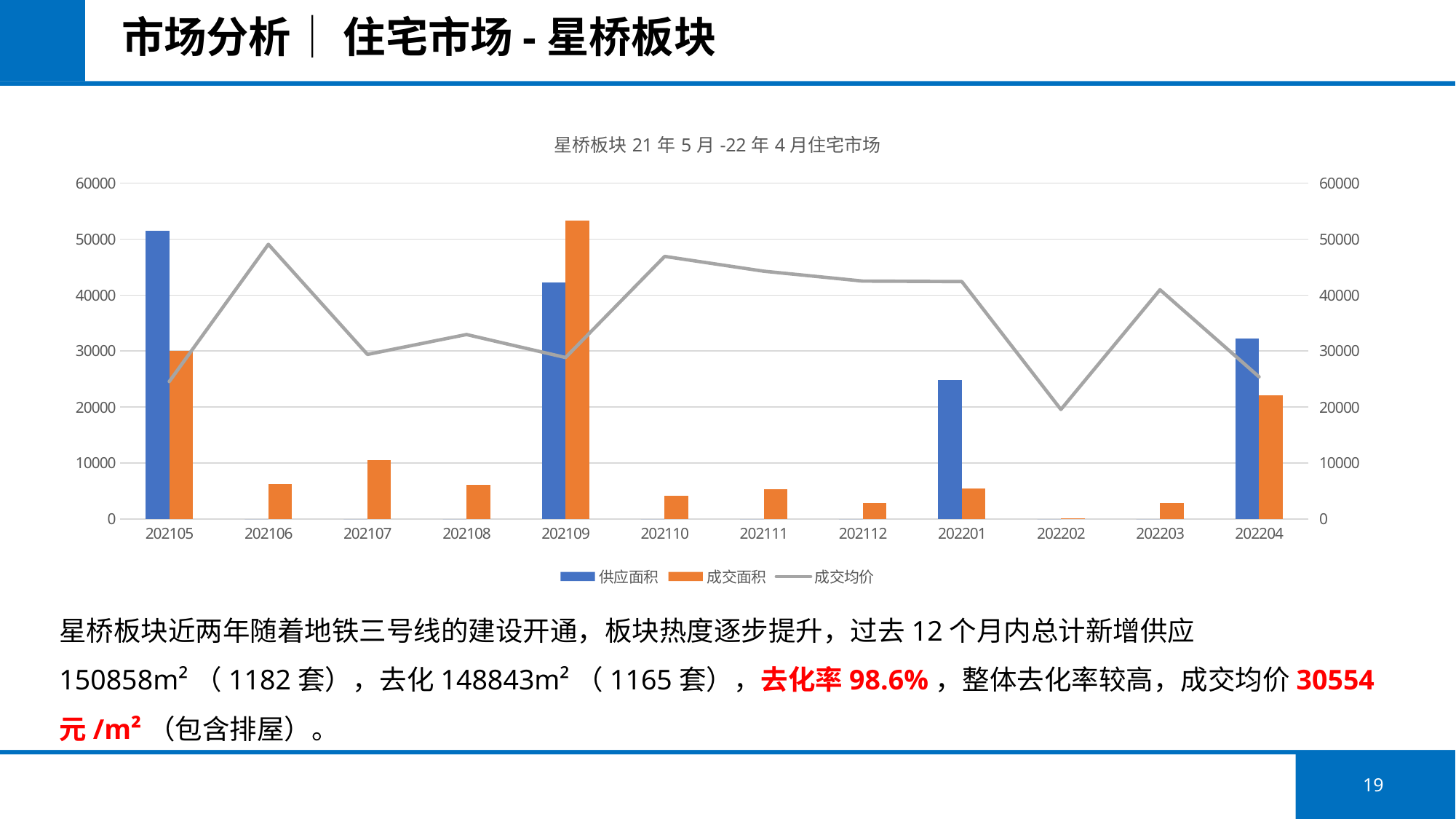
In 202105, which is larger, 供应面积 or 成交面积? 供应面积 What kind of chart is shown on the slide? A combined bar and line chart What is the title of the chart? 星桥板块 21 年 5 月 -22 年 4 月住宅市场 Does the 成交均价 line rise or fall from 202110 to 202202? Fall How many months are shown on the x axis of the chart? 12 Which month has the highest 供应面积 bar? 202105 How many series does the chart legend list? 3 Is the 成交面积 value for 202109 greater or less than 50000? greater Is the 成交均价 value for 202202 greater or less than 30000? less Is the 供应面积 value for 202201 greater or less than 20000? greater Which month has the lowest 成交均价 on the line? 202202 Which month has the highest 成交面积 bar? 202109